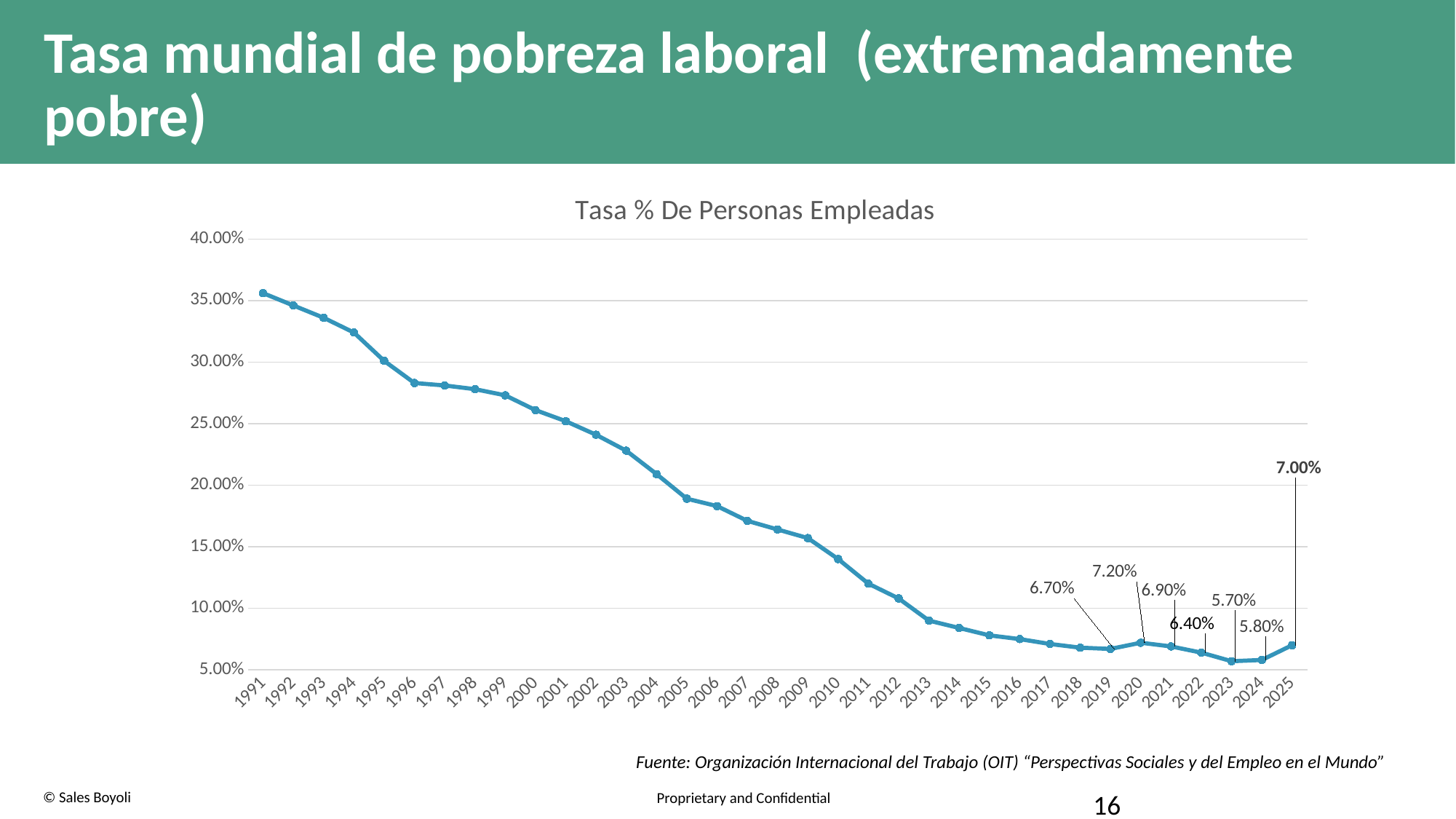
Which year has the highest value on the chart? 1991 What is the value for 2025? 7.00% Which year has the lowest value among the labelled points? 2023 What kind of chart is shown on the slide? line chart Overall, do the values rise or fall from 1991 to 2025? fall What is the value for 2020? 7.20% What is the difference between the values for 2020 and 2019? 0.50% What is the value for 2019? 6.70% What is the title of the chart? Tasa % De Personas Empleadas What is the value for 2023? 5.70% Which is larger, the value for 2021 or the value for 2022? 2021 Is the value for 2010 greater or less than 15.00%? less